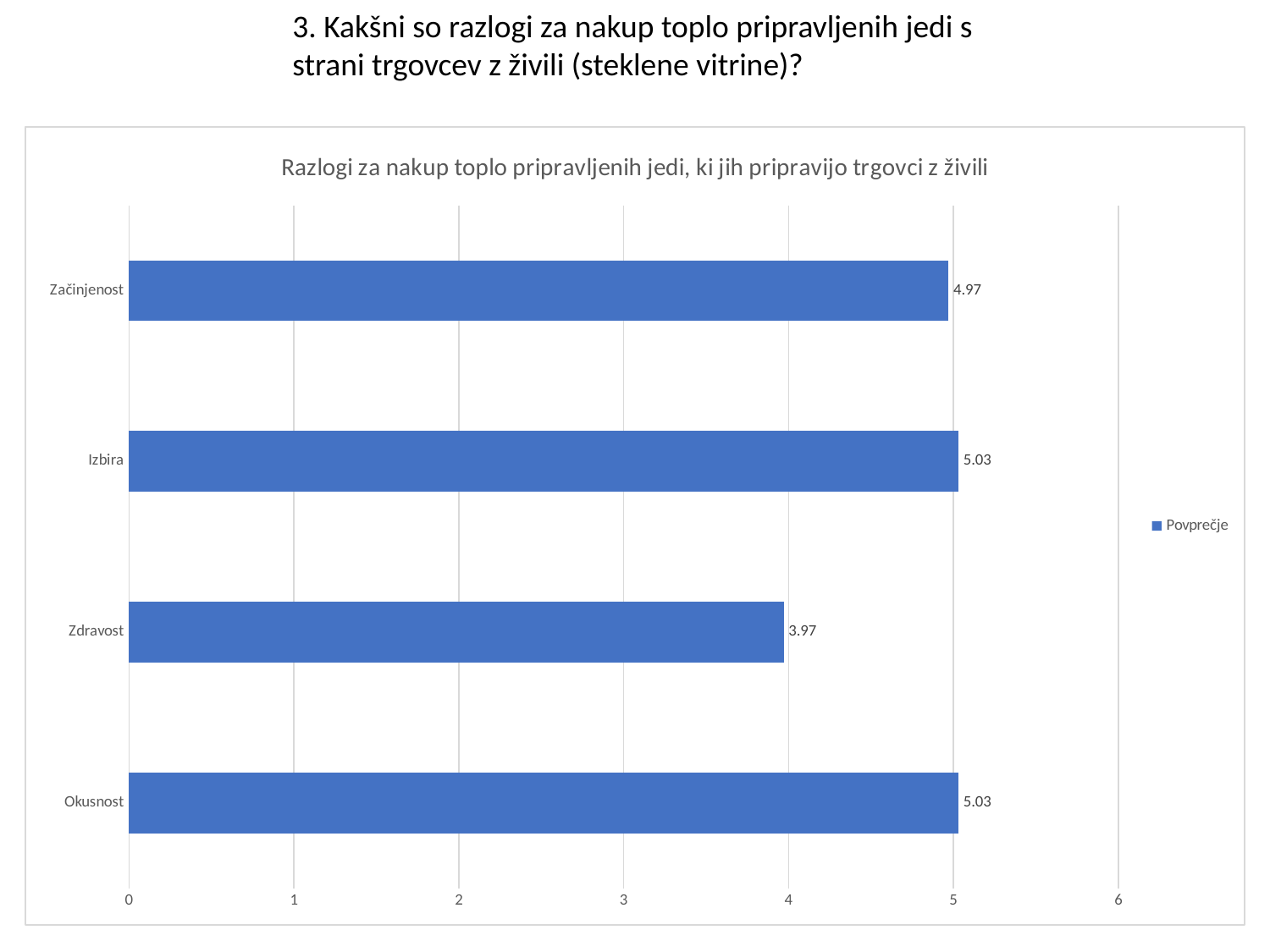
What is the value for Začinjenost? 4.97 What is the difference between the values for Začinjenost and Zdravost? 1.00 What is the value for Izbira? 5.03 Which category has the lowest value? Zdravost What is the difference between the values for Izbira and Zdravost? 1.06 What is the value for Zdravost? 3.97 How many series does the legend list? 1 How many categories are shown in the chart? 4 What is the value for Okusnost? 5.03 What kind of chart is shown on the slide? bar chart Which is larger, the value for Začinjenost or the value for Zdravost? Začinjenost Is the value for Zdravost greater or less than 4? less